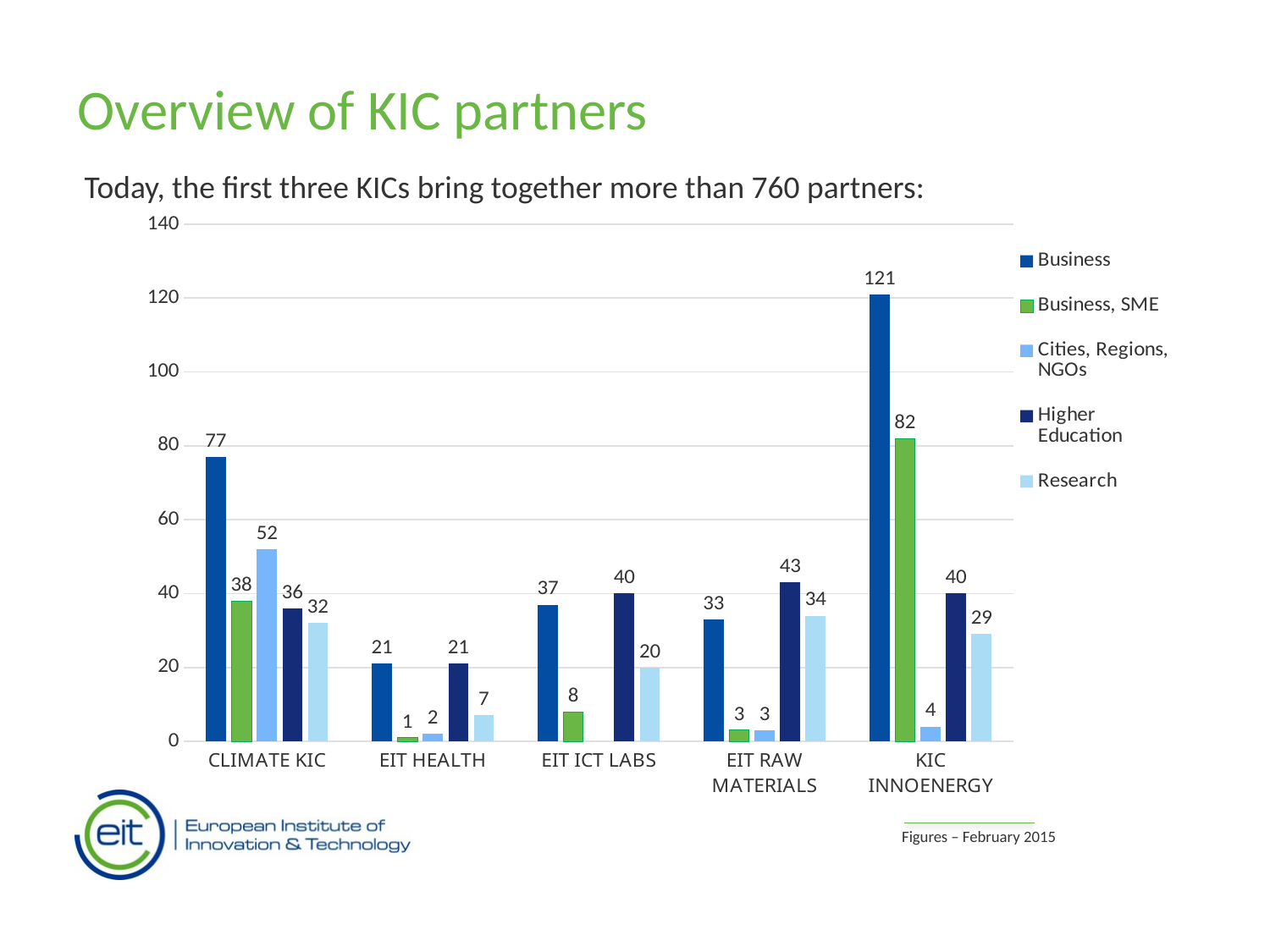
What is the Business value for KIC INNOENERGY? 121 What kind of chart is shown on the slide? bar chart Which KIC has the lowest Business, SME value? EIT HEALTH Is the Business value for KIC INNOENERGY greater or less than 100? greater Which KIC has the highest Business value? KIC INNOENERGY What is the Higher Education value for EIT RAW MATERIALS? 43 What is the Research value for CLIMATE KIC? 32 What is the difference between the Business values for KIC INNOENERGY and CLIMATE KIC? 44 What is the total of all five series values for CLIMATE KIC? 235 Which is larger: the Business, SME value for KIC INNOENERGY or for CLIMATE KIC? KIC INNOENERGY How many series does the legend list? 5 How many KICs are shown on the x axis? 5